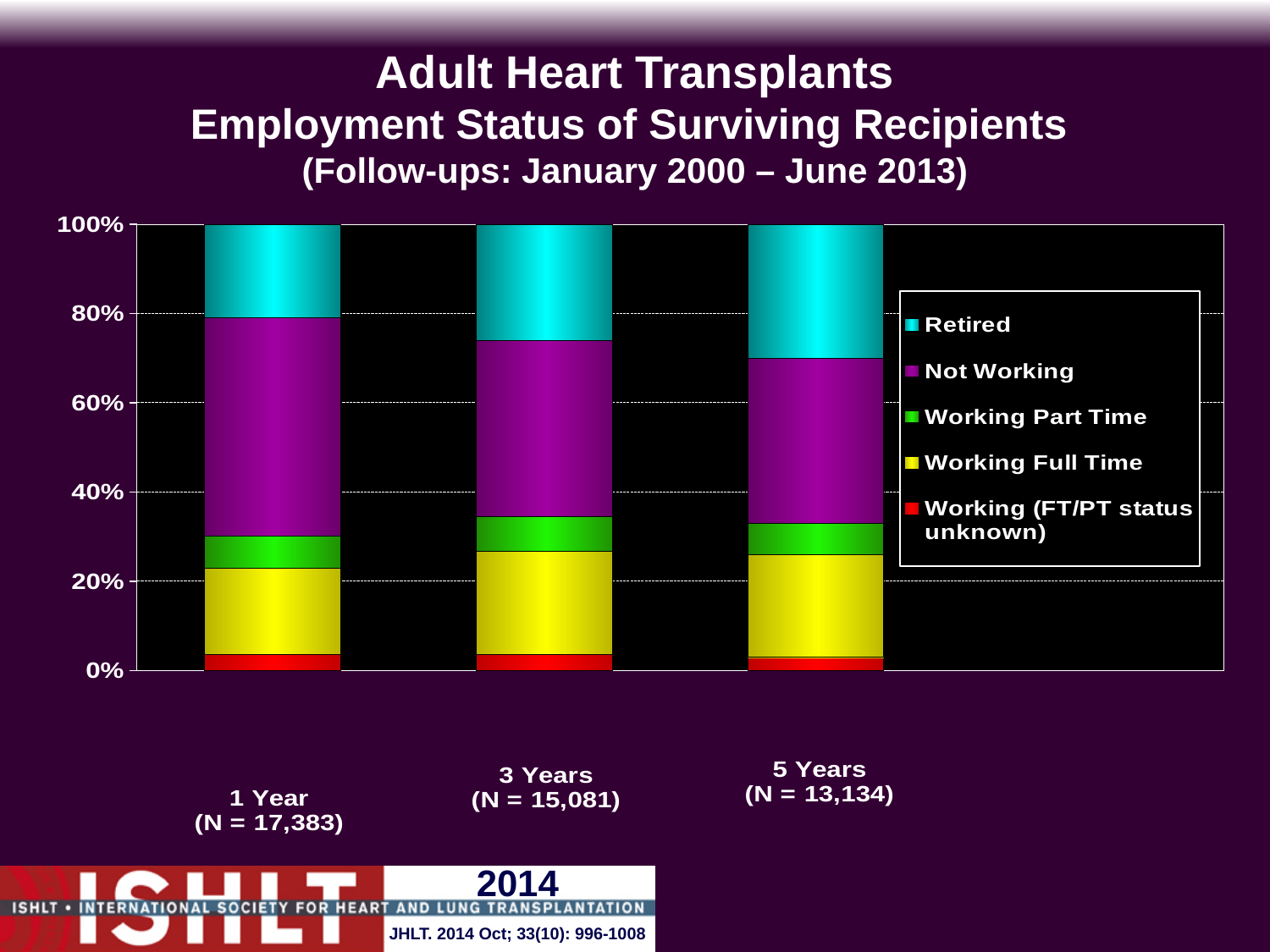
What colour represents the Retired series in the legend? Cyan (light blue) Which follow-up time has the largest Retired segment? 5 Years Is the Retired share for the 5 Years bar greater or less than 20%? greater How many follow-up time categories are plotted on the x axis? 3 What is the N shown for the 3 Years category? N = 15,081 Which follow-up time has the largest Not Working segment? 1 Year Is the Working Full Time share for the 3 Years bar greater or less than 20%? greater What kind of chart is shown on the slide? Stacked bar chart How many series does the legend list? 5 Is the Retired segment larger for the 1 Year bar or the 5 Years bar? 5 Years Is the Not Working share for the 1 Year bar greater or less than 40%? greater Does the Retired share rise or fall from 1 Year to 5 Years? Rise